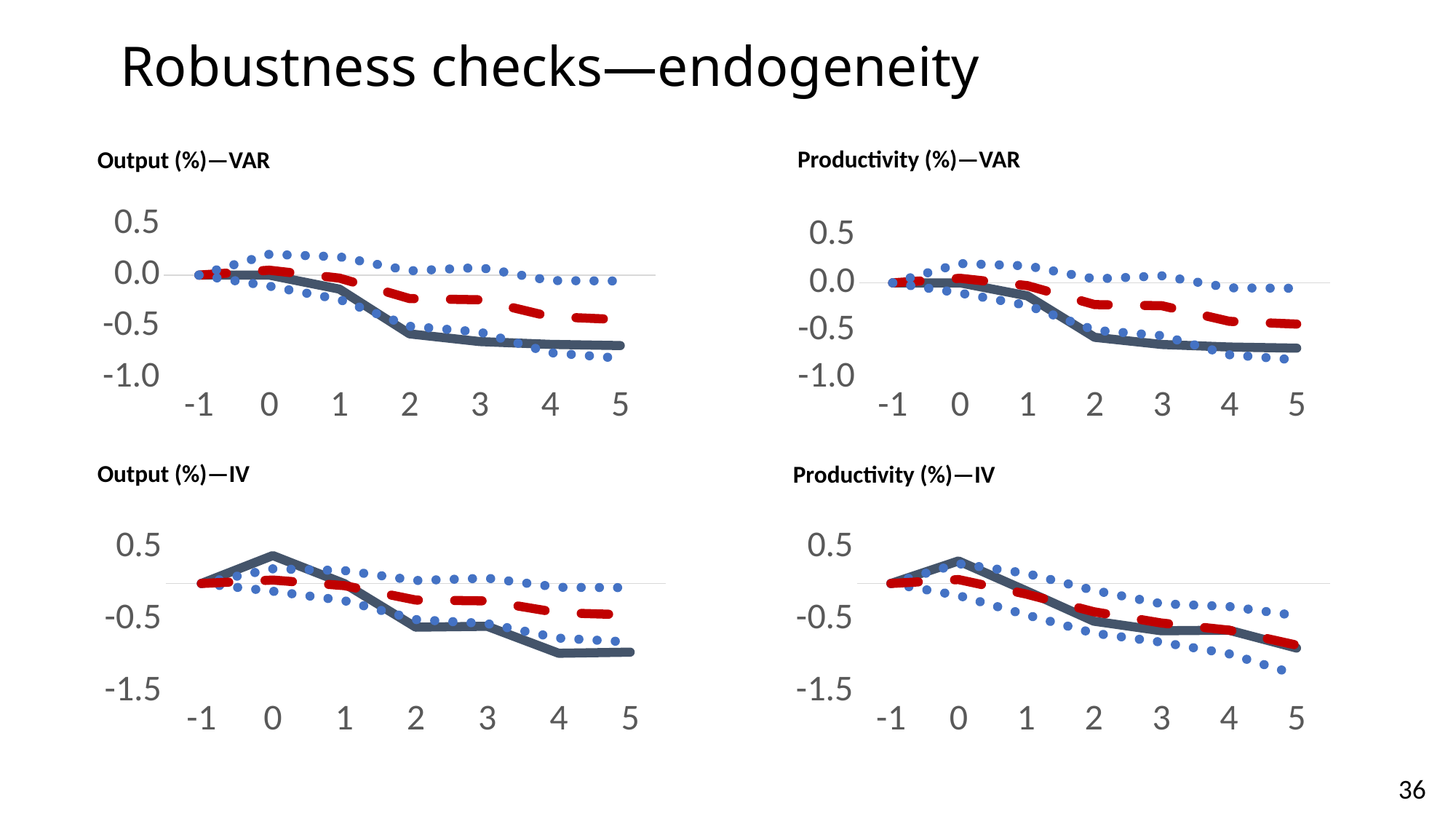
How many x-axis points are plotted in the "Productivity (%)—IV" chart? 7 In the "Output (%)—VAR" chart, what is the lowest value shown on the y axis? -1.0 In the "Productivity (%)—IV" chart, does the solid line rise or fall from x = -1 to x = 0? rise What kind of chart is the "Output (%)—VAR" chart? line chart In the "Output (%)—IV" chart, is the value of the solid line at x = 4 greater or less than -0.5? less In the "Productivity (%)—IV" chart, is the value of the solid line at x = 5 greater or less than -0.5? less In the "Productivity (%)—VAR" chart, which is larger at x = 5: the solid line or the red dashed line? the red dashed line In the "Output (%)—VAR" chart, is the value of the red dashed line at x = 2 greater or less than -0.5? greater How many charts are shown on the slide? 4 In the "Output (%)—IV" chart, what is the lowest value shown on the y axis? -1.5 In the "Output (%)—VAR" chart, does the solid line generally rise or fall from x = 0 to x = 5? fall